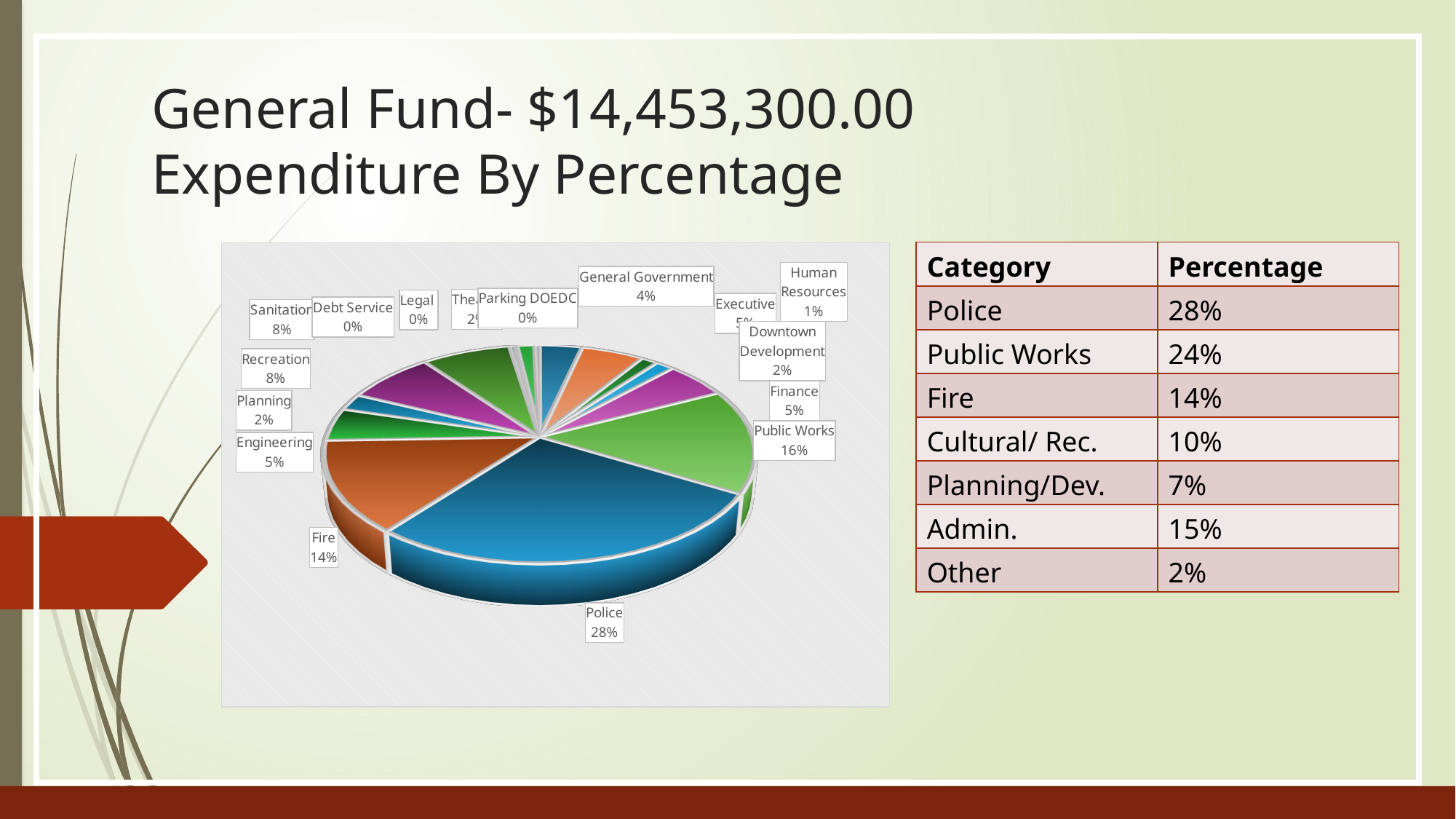
What share of the pie does the Police slice represent? 28% What percentage does the Public Works slice represent in the pie chart? 16% What percentage of the General Fund expenditure goes to Fire? 14% Which category has the largest slice of the pie chart? Police What percentage of the General Fund expenditure goes to Police? 28% What percentage is shown for Human Resources in the pie chart? 1% What percentage is shown for General Government in the pie chart? 4% What percentage is shown for Sanitation in the pie chart? 8% What is the difference between the Police and Fire percentages in the pie chart? 14% What kind of chart is shown on the slide? pie chart What percentage is shown for Debt Service in the pie chart? 0% Which slice is larger in the pie chart, Public Works or Fire? Public Works